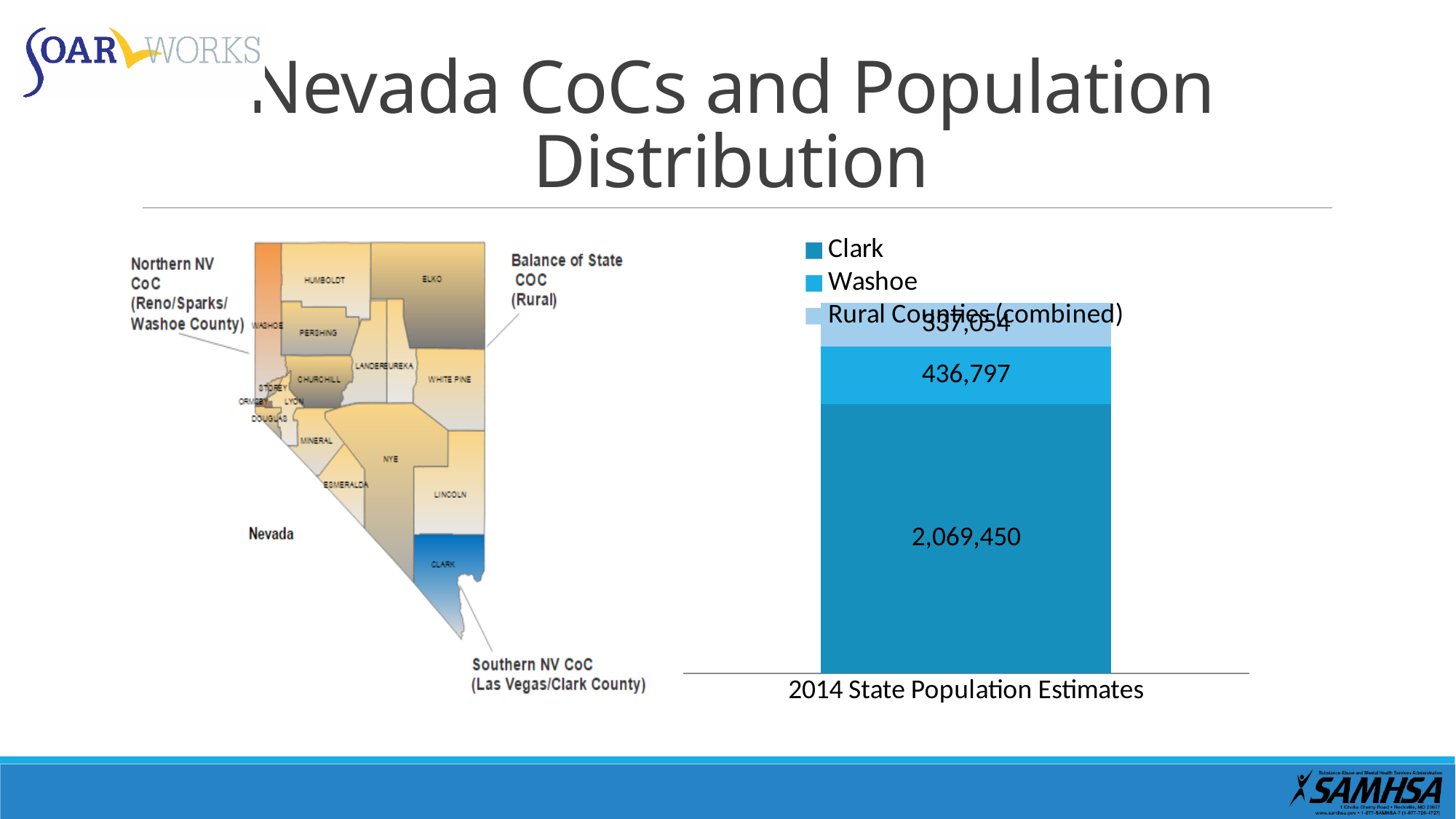
How many series does the chart legend list? 3 What is the value for Washoe in the 2014 State Population Estimates bar? 436,797 Which series is listed first in the chart legend? Clark What is the category label shown under the stacked bar? 2014 State Population Estimates Which series has the smallest segment in the stacked bar? Rural Counties (combined) What is the value for Clark in the 2014 State Population Estimates bar? 2,069,450 How many bars (categories) are plotted on the x axis of the chart? 1 Which is larger, the value for Clark or the value for Washoe? Clark Which series has the largest segment in the stacked bar? Clark Which is larger, the value for Washoe or the value for Rural Counties (combined)? Washoe What kind of chart is shown on the right side of the slide? bar chart What is the difference between the Clark value and the Washoe value? 1,632,653